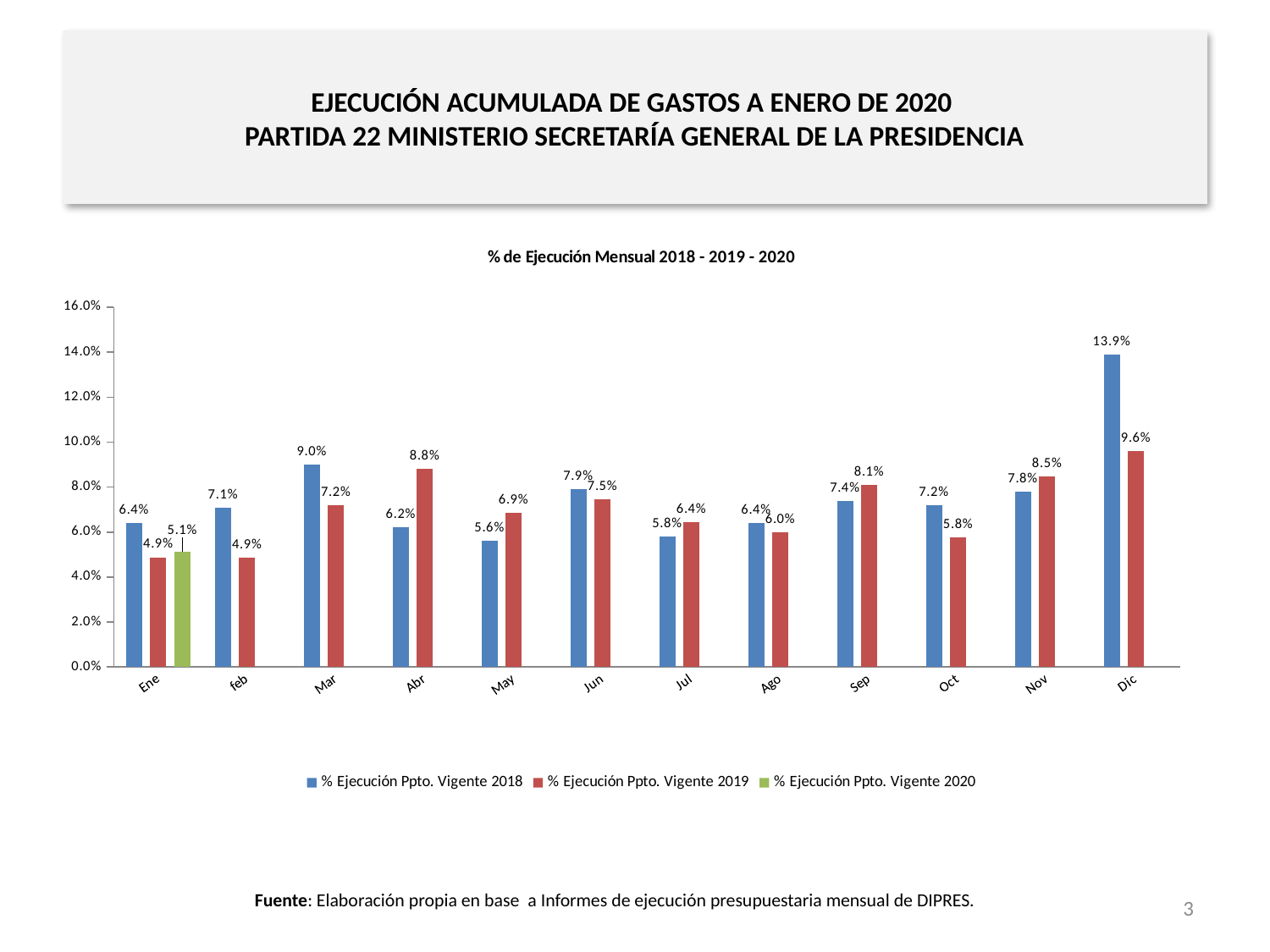
Is the value for % Ejecución Ppto. Vigente 2018 in Dic greater or less than 12.0%? greater Which month has the highest value for % Ejecución Ppto. Vigente 2019? Dic How many months are shown on the x axis? 12 In Mar, which series is larger: % Ejecución Ppto. Vigente 2018 or % Ejecución Ppto. Vigente 2019? % Ejecución Ppto. Vigente 2018 What kind of chart is shown on the slide? Bar chart What is the difference between the 2018 and 2019 values in Dic? 4.3% What is the value for % Ejecución Ppto. Vigente 2019 in Abr? 8.8% How many series does the legend list? 3 Which month has the lowest value for % Ejecución Ppto. Vigente 2018? May What is the title of the chart? % de Ejecución Mensual 2018 - 2019 - 2020 What is the value for % Ejecución Ppto. Vigente 2020 in Ene? 5.1% What is the value for % Ejecución Ppto. Vigente 2018 in Dic? 13.9%